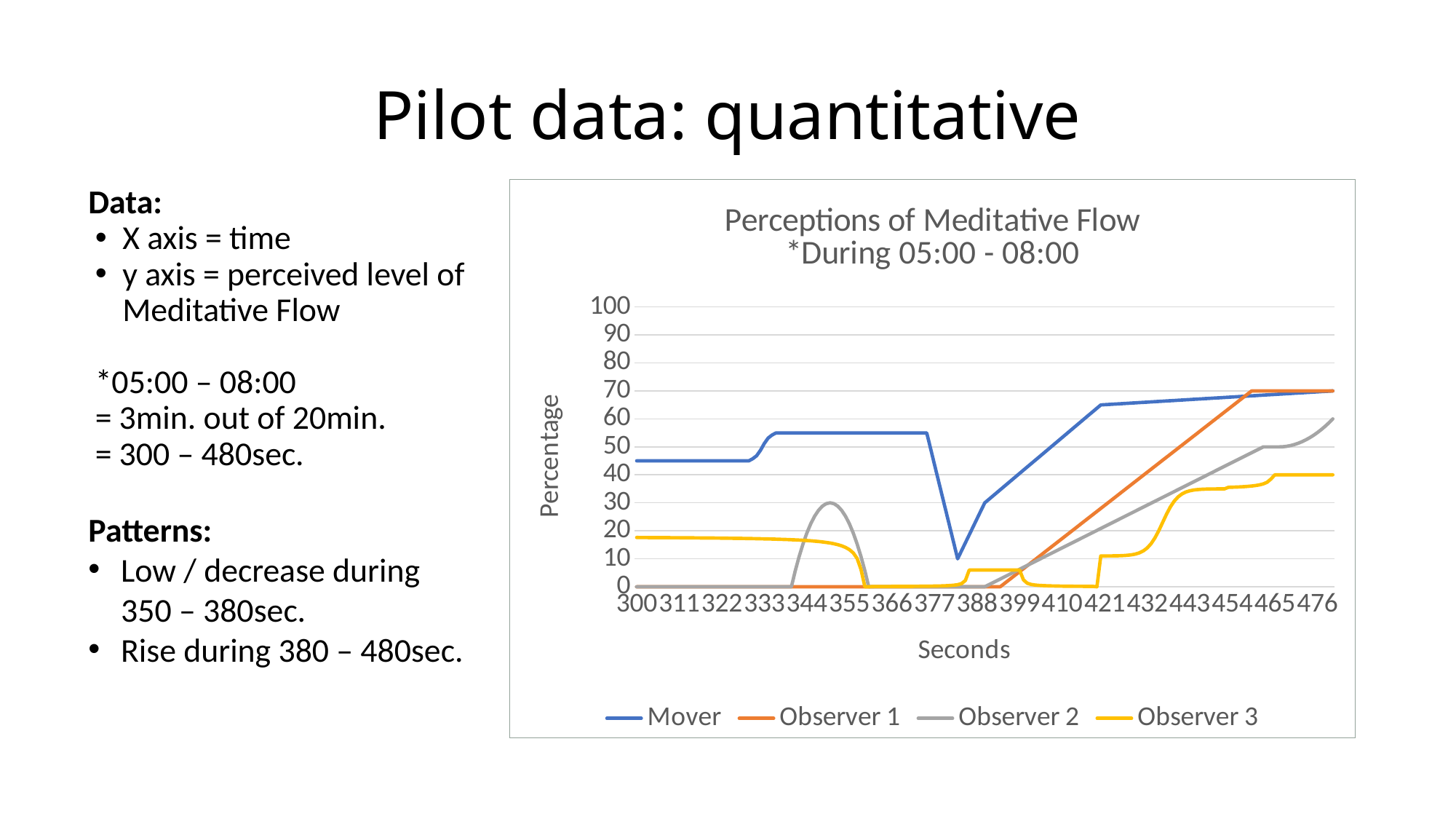
How many series does the chart legend list? 4 Is the value for Observer 3 at 476 seconds greater or less than 50? less Is the value for Mover at 300 seconds greater or less than 40? greater What is the label of the y axis of the chart? Percentage Is the value for Observer 1 at 476 seconds greater or less than 60? greater What kind of chart is shown on the slide? line chart At 476 seconds, which series has the lowest value? Observer 3 At 300 seconds, which is larger, the value for Mover or the value for Observer 3? Mover Does the Observer 1 line rise or fall between 388 and 476 seconds? rise What is the label of the x axis of the chart? Seconds